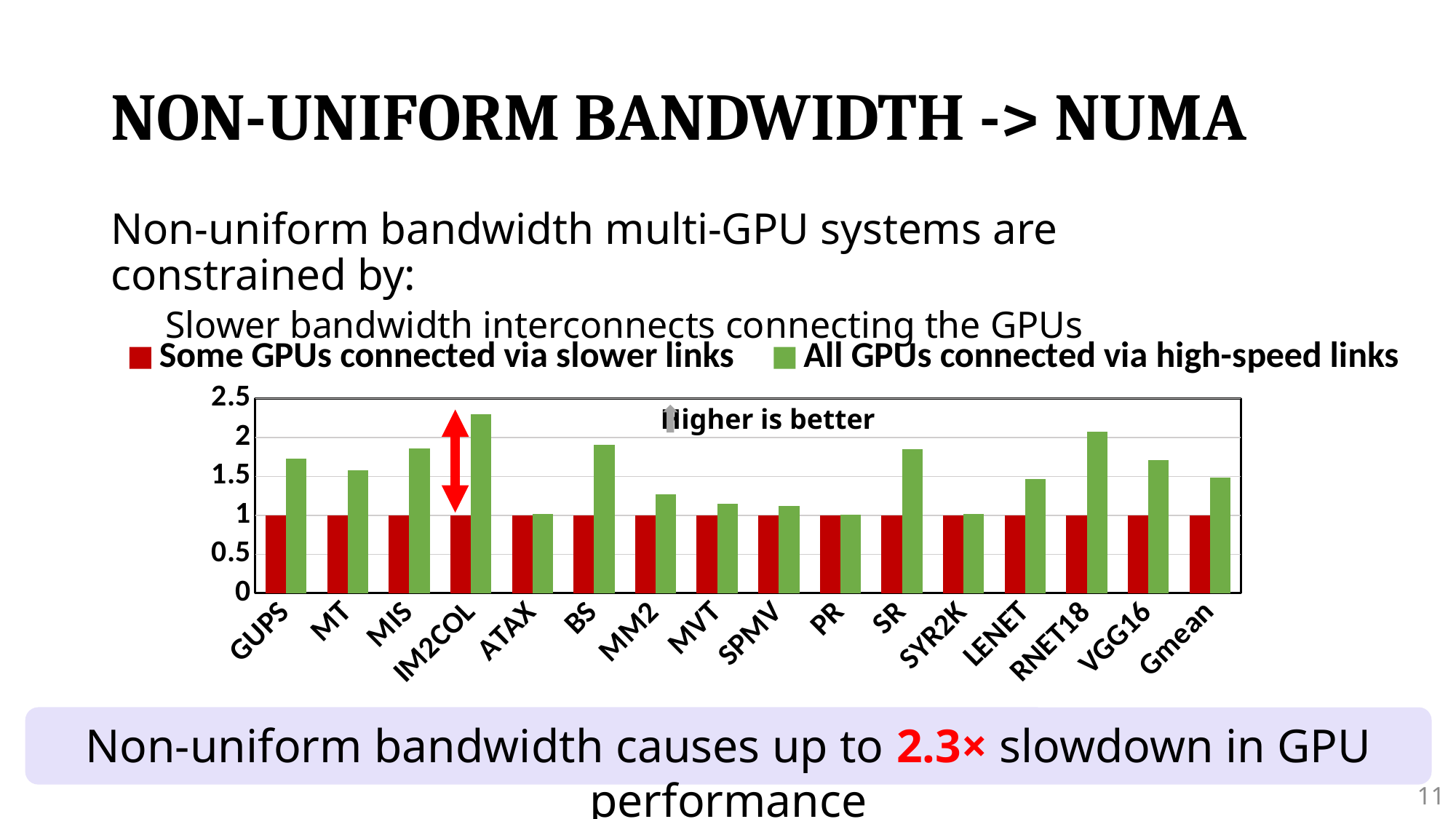
Is the 'All GPUs connected via high-speed links' value for ATAX greater or less than 1.5? less What colour are the bars for the 'Some GPUs connected via slower links' series? red How many categories are shown along the x axis of the chart? 16 Is the 'All GPUs connected via high-speed links' value for BS greater or less than 1.5? greater For the 'All GPUs connected via high-speed links' series, which is larger: GUPS or MT? GUPS Is the 'All GPUs connected via high-speed links' value for IM2COL greater or less than 2? greater What is the value of the 'Some GPUs connected via slower links' bar for GUPS? 1 What kind of chart is shown on the slide? bar chart For the 'All GPUs connected via high-speed links' series, which is larger: RNET18 or LENET? RNET18 How many series does the chart legend list? 2 Which category has the highest value for the 'All GPUs connected via high-speed links' series? IM2COL